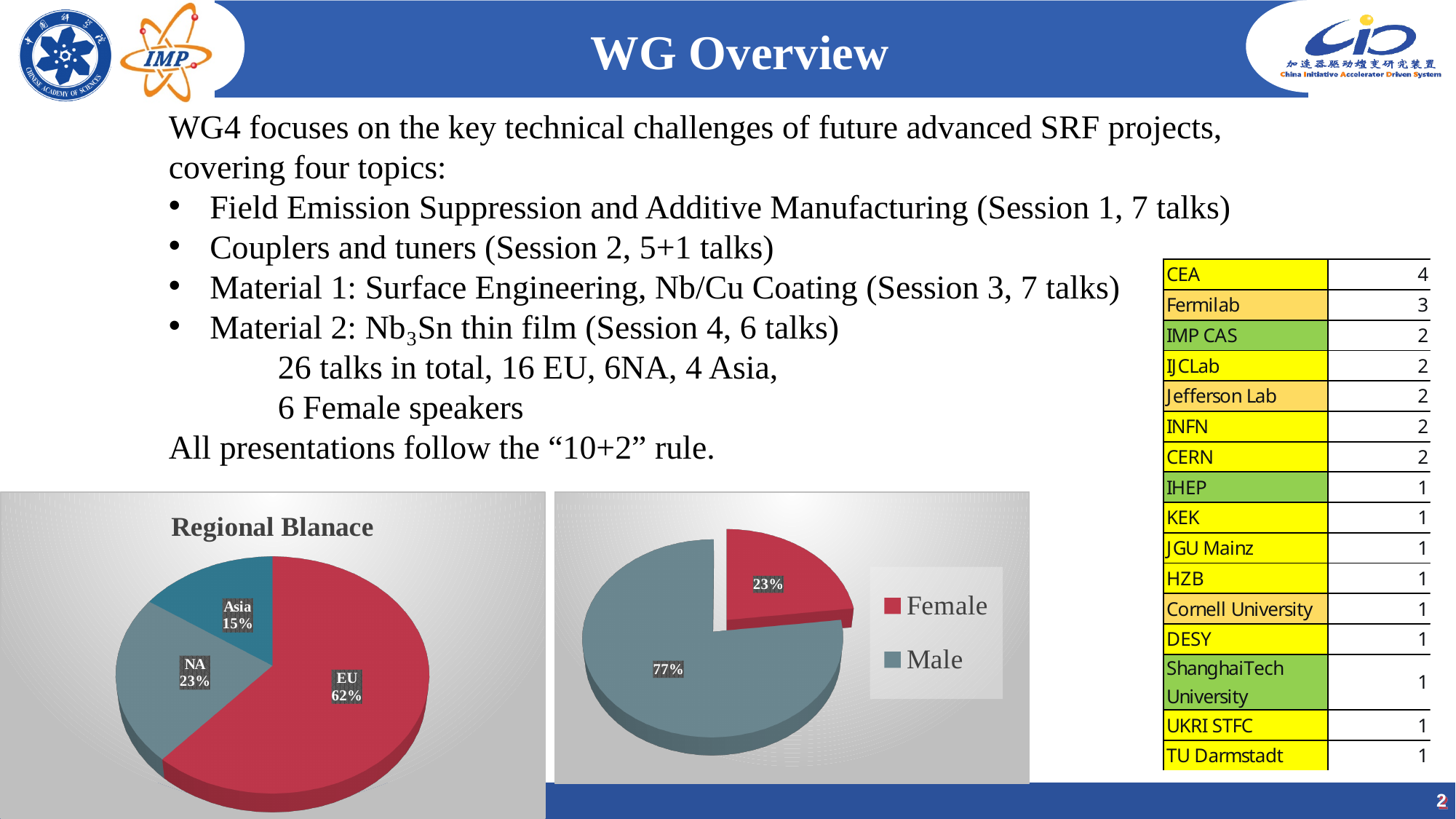
In the Regional Blanace chart, what share does EU have? 62% In the pie chart on the right of the slide, what share is Female? 23% What kind of chart is the Regional Blanace chart? Pie chart How many entries does the legend of the pie chart on the right of the slide list? 2 In the Regional Blanace chart, which region has the largest slice? EU In the Regional Blanace chart, what share does NA have? 23% In the Regional Blanace chart, which region has the smallest slice? Asia In the pie chart on the right of the slide, what share is Male? 77% In the Regional Blanace chart, what share does Asia have? 15% In the Regional Blanace chart, what is the difference in percentage points between EU and NA? 39 In the Regional Blanace chart, how many regions are shown? 3 In the pie chart on the right of the slide, which is larger, Female or Male? Male